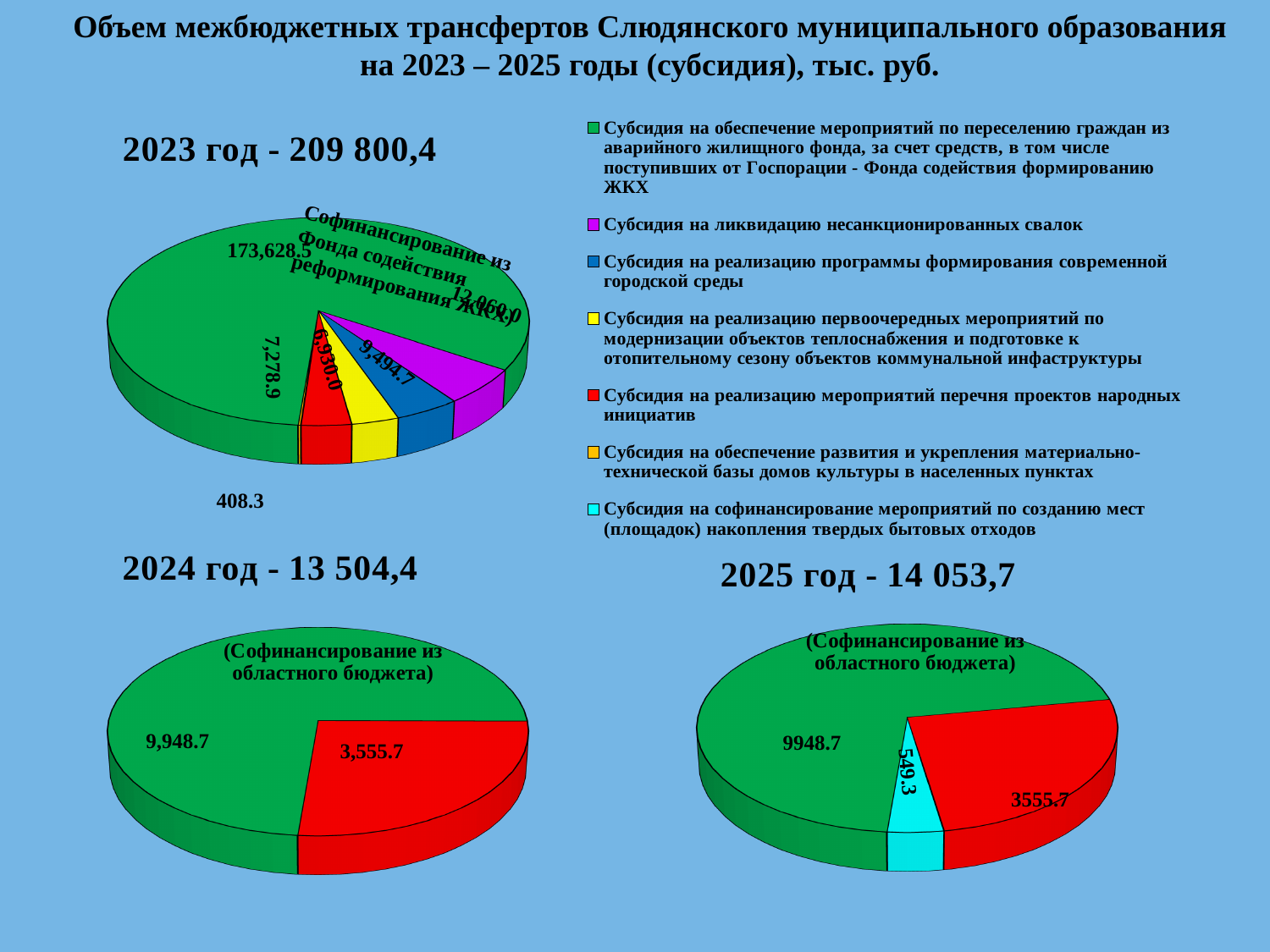
How many entries does the legend on the slide list? 7 In the 2025 pie chart, what is the value of the cyan slice (solid waste collection sites)? 549.3 How many pie charts are shown on the slide? 3 In the 2023 pie chart, how many slices are there? 6 In the 2023 pie chart, what is the value of the largest (green) slice? 173,628.5 In the 2024 pie chart, what is the difference between the green slice and the red slice? 6,393.0 In the 2024 pie chart, what is the value of the red slice? 3,555.7 In the 2023 pie chart, which slice has the smallest value? 408.3 (orange slice, houses of culture) In the 2023 pie chart, what is the value of the red slice (people's initiatives projects)? 7,278.9 What type of chart is used for the 2023 data? Pie chart In the 2023 pie chart, what is the value of the blue slice (subsidy for the modern urban environment programme)? 9,494.7 In the 2025 pie chart, which is larger: the red slice or the cyan slice? Red slice (3555.7)